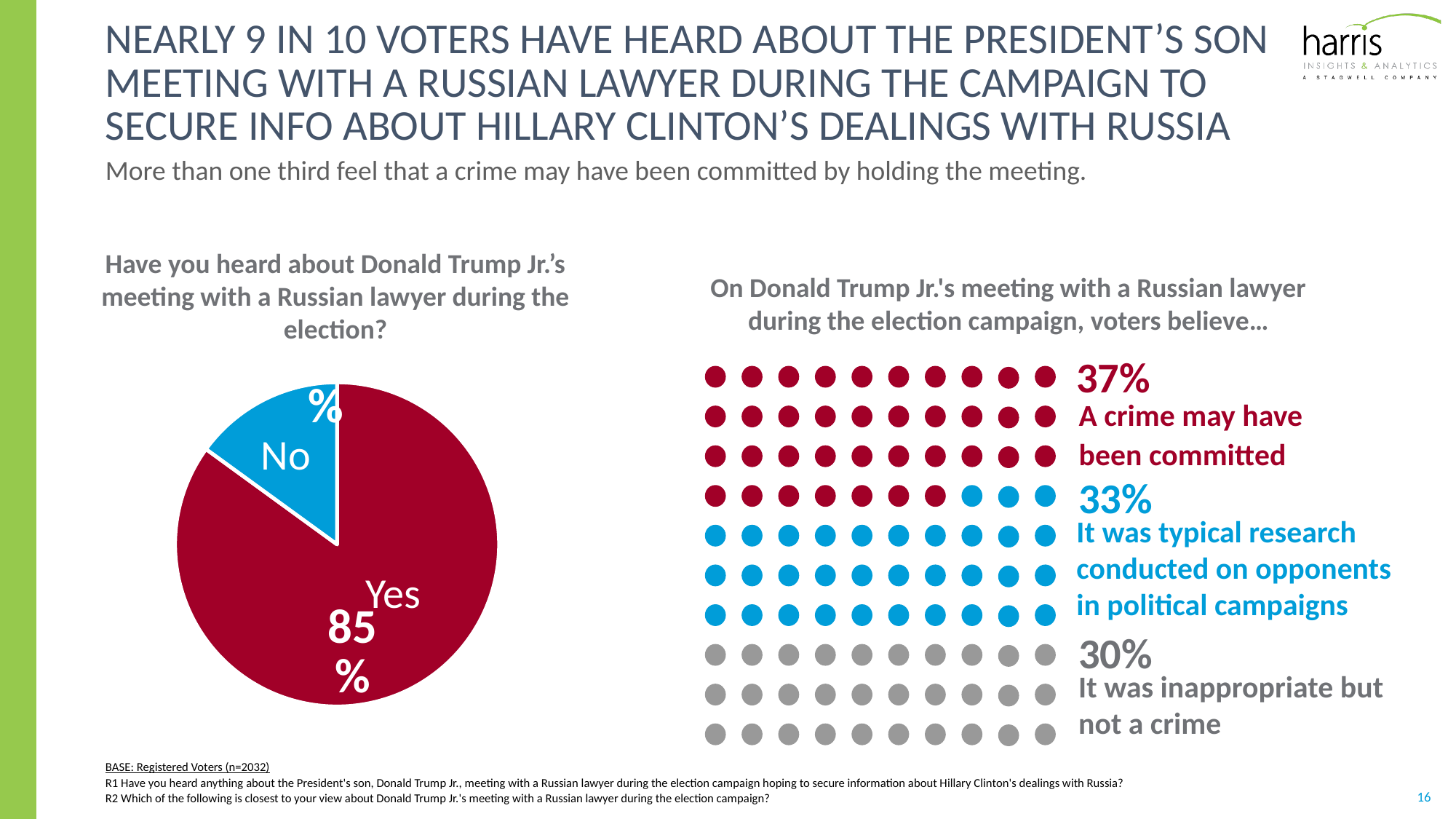
What kind of chart is shown on the left of the slide? Pie chart In the chart on the right, which belief has the lowest percentage? It was inappropriate but not a crime How many slices does the pie chart on the left have? 2 In the chart on the right, what percentage of voters believe it was typical research conducted on opponents in political campaigns? 33% How many response categories are shown in the chart on the right? 3 In the pie chart on the left, which response has the larger share, Yes or No? Yes In the chart on the right, what percentage of voters believe it was inappropriate but not a crime? 30% In the pie chart on the left, what colour is the Yes slice? Red In the chart on the right, what percentage of voters believe a crime may have been committed? 37% In the chart on the right, what is the difference in percentage points between 'A crime may have been committed' and 'It was inappropriate but not a crime'? 7 percentage points In the chart on the right, which belief has the highest percentage? A crime may have been committed In the pie chart on the left, what percentage of voters answered Yes? 85%